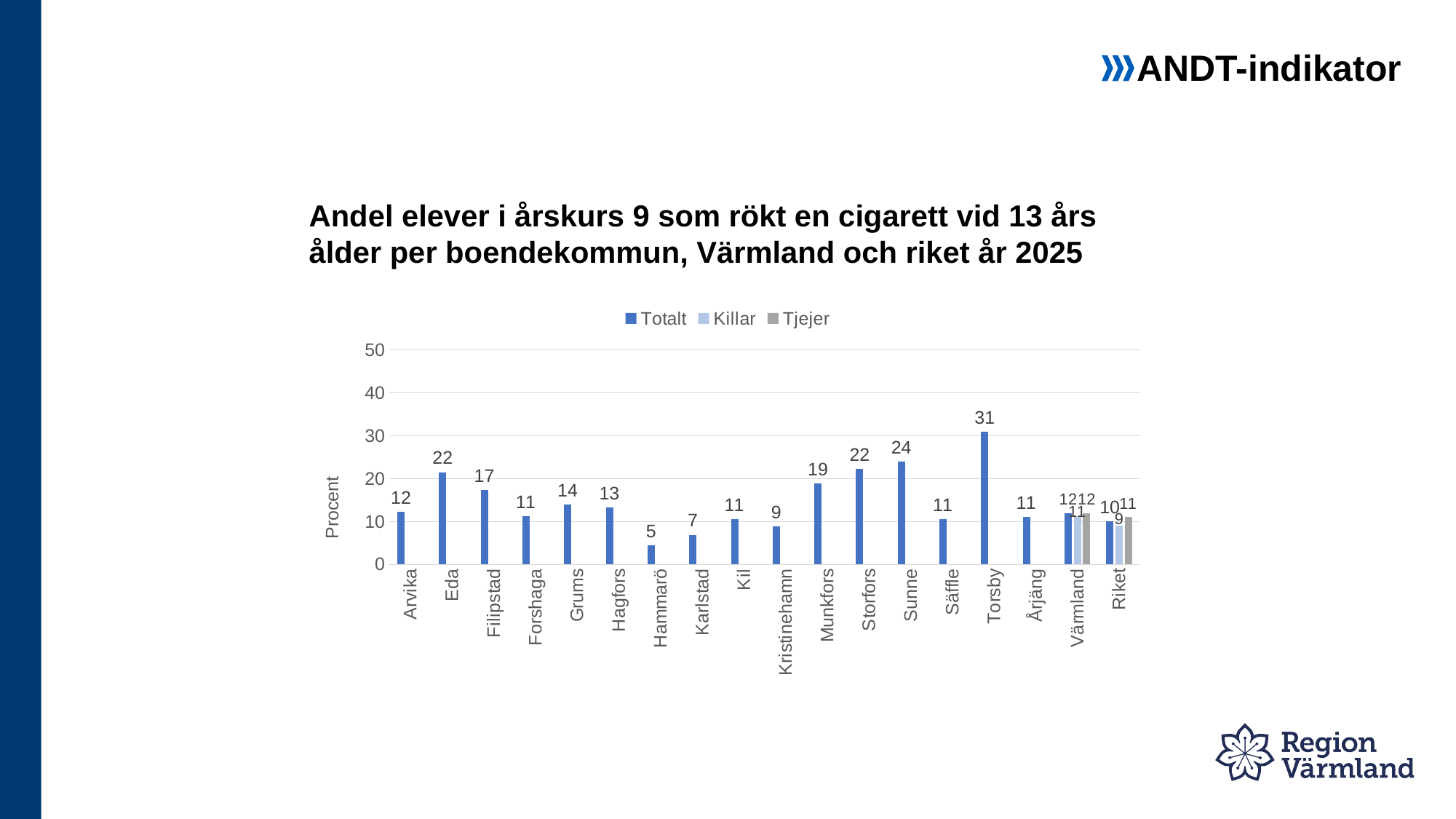
What is the Totalt value for Sunne? 24 What is the Totalt value for Eda? 22 What is the label on the y axis? Procent What is the Tjejer value for Riket? 11 What kind of chart is shown on the slide? bar chart What is the Killar value for Värmland? 11 Which category has the highest Totalt value? Torsby What is the difference between the Totalt values for Torsby and Hammarö? 26 Which has a higher Totalt value, Munkfors or Filipstad? Munkfors How many series does the legend list? 3 Which category has the lowest Totalt value? Hammarö How many categories are shown on the x axis? 18